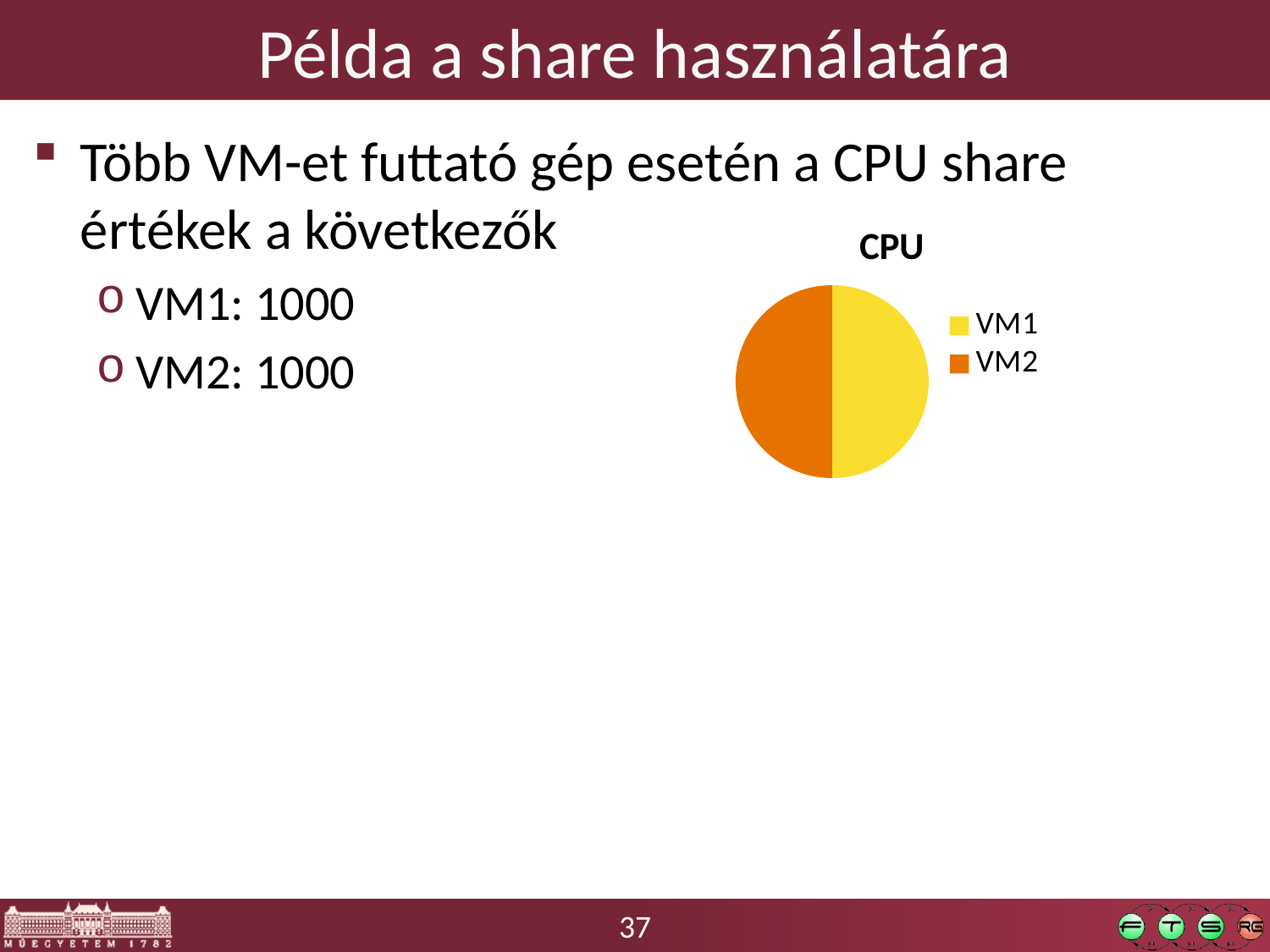
What is the difference between the CPU share values of VM1 and VM2? 0 How many slices does the pie chart have? 2 How many entries does the chart legend list? 2 Which legend entries are shown for the pie chart? VM1 and VM2 What is the title of the chart? CPU What is the CPU share value for VM2 according to the slide? 1000 What is the CPU share value for VM1 according to the slide? 1000 What share of the pie does the VM2 slice take? 50% What share of the pie does the VM1 slice take? 50% What kind of chart is shown on the slide? pie chart